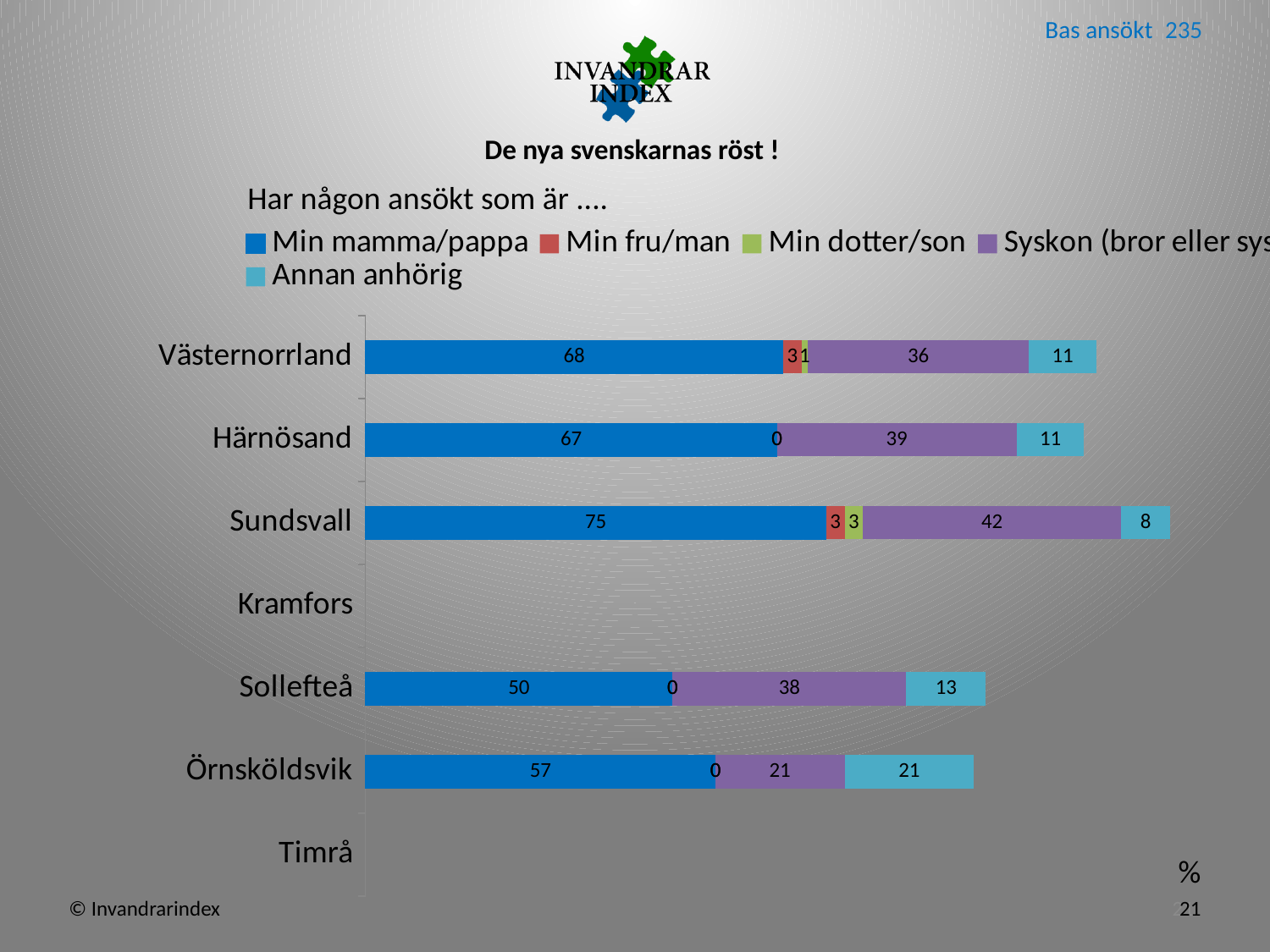
Which has the larger Syskon value, Sundsvall or Västernorrland? Sundsvall What is the value for Annan anhörig for Örnsköldsvik? 21 How many series does the legend list? 5 What is the difference between the Min mamma/pappa values for Sundsvall and Sollefteå? 25 What is the value for Syskon for Härnösand? 39 Among the categories with plotted bars, which has the lowest value for Min mamma/pappa? Sollefteå What kind of chart is shown on the slide? bar chart What is the value for Min mamma/pappa for Sundsvall? 75 How many categories are listed on the vertical axis? 7 What is the total of the stacked bar for Sundsvall? 131 What is the value for Annan anhörig for Sollefteå? 13 Which category has the highest value for Min mamma/pappa? Sundsvall